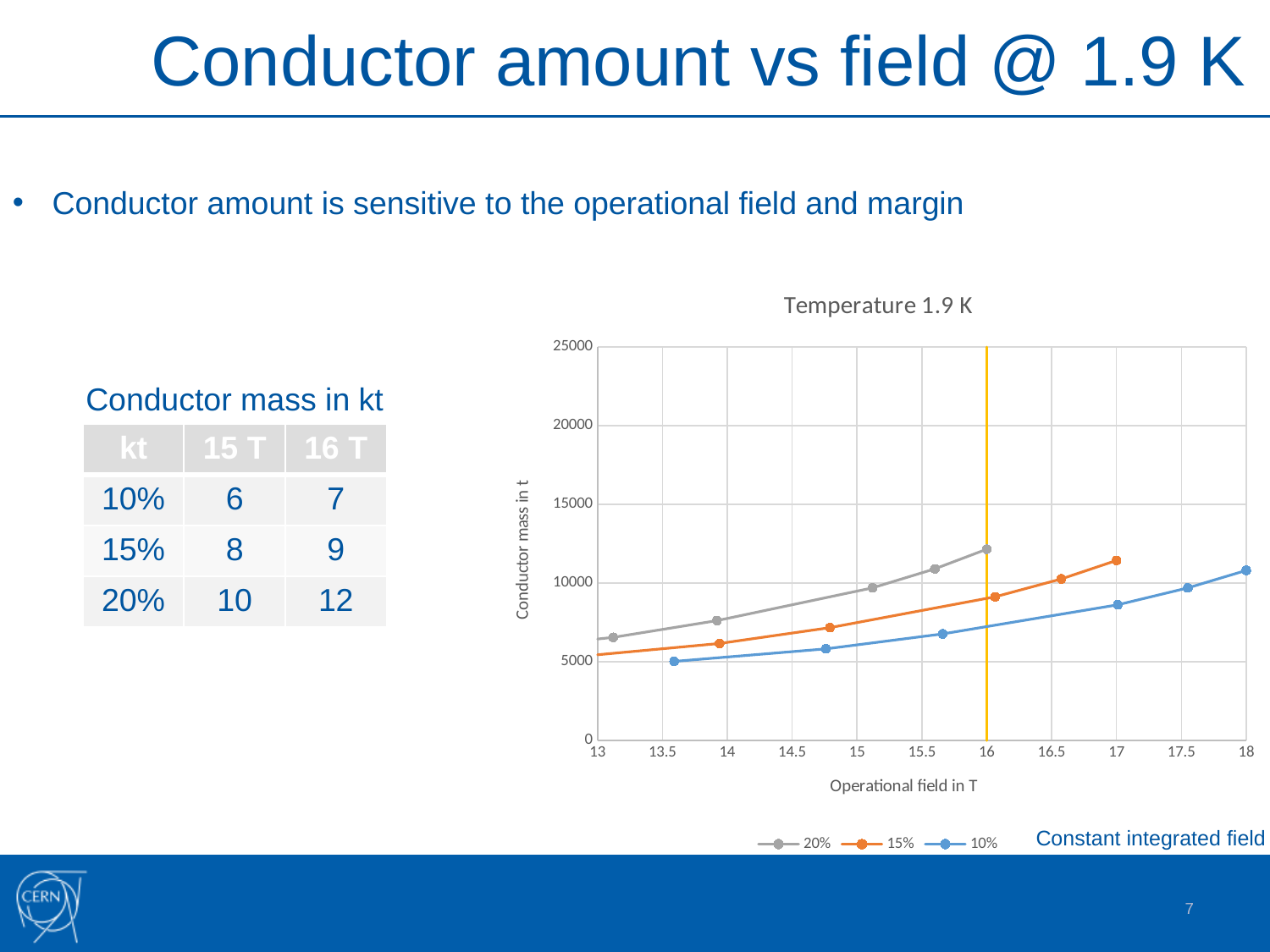
At an operational field of 16 T, which series has the larger conductor mass, 20% or 15%? 20% What kind of chart is shown on the slide? line chart Is the conductor mass for the 20% series at 16 T greater or less than 10000? greater Is the conductor mass for the 10% series at 15.5 T greater or less than 10000? less Is the conductor mass for the 15% series at 17 T greater or less than 10000? greater Which series has the highest conductor mass at any given operational field? 20% Which series has the lowest conductor mass at any given operational field? 10% How many series does the chart legend list? 3 What is the label of the chart's x axis? Operational field in T What is the title of the chart? Temperature 1.9 K Does the conductor mass for the 10% series rise or fall as the operational field increases? rise Does the conductor mass for the 20% series rise or fall as the operational field increases? rise